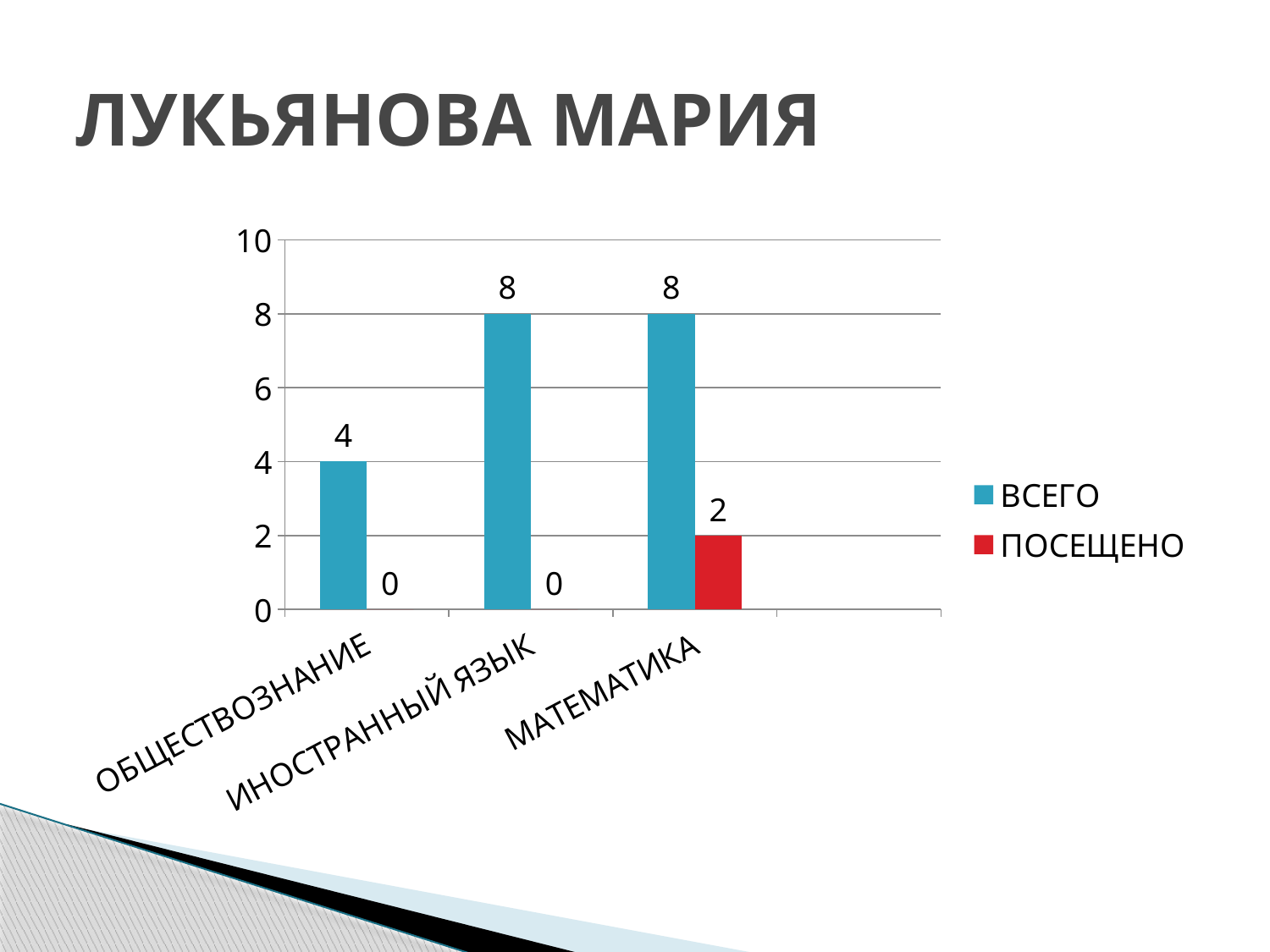
What is the ВСЕГО value for ОБЩЕСТВОЗНАНИЕ? 4 Which is larger: the ВСЕГО value for ОБЩЕСТВОЗНАНИЕ or the ПОСЕЩЕНО value for МАТЕМАТИКА? ВСЕГО value for ОБЩЕСТВОЗНАНИЕ What is the ПОСЕЩЕНО value for МАТЕМАТИКА? 2 How many series does the legend list? 2 Which category has the highest ПОСЕЩЕНО value? МАТЕМАТИКА Which category has the lowest ВСЕГО value? ОБЩЕСТВОЗНАНИЕ What kind of chart is shown on the slide? Bar chart What is the difference between the ВСЕГО and ПОСЕЩЕНО values for МАТЕМАТИКА? 6 What is the difference between the ВСЕГО values for ИНОСТРАННЫЙ ЯЗЫК and ОБЩЕСТВОЗНАНИЕ? 4 How many categories are shown on the x axis? 3 What is the ВСЕГО value for ИНОСТРАННЫЙ ЯЗЫК? 8 What is the ПОСЕЩЕНО value for ОБЩЕСТВОЗНАНИЕ? 0